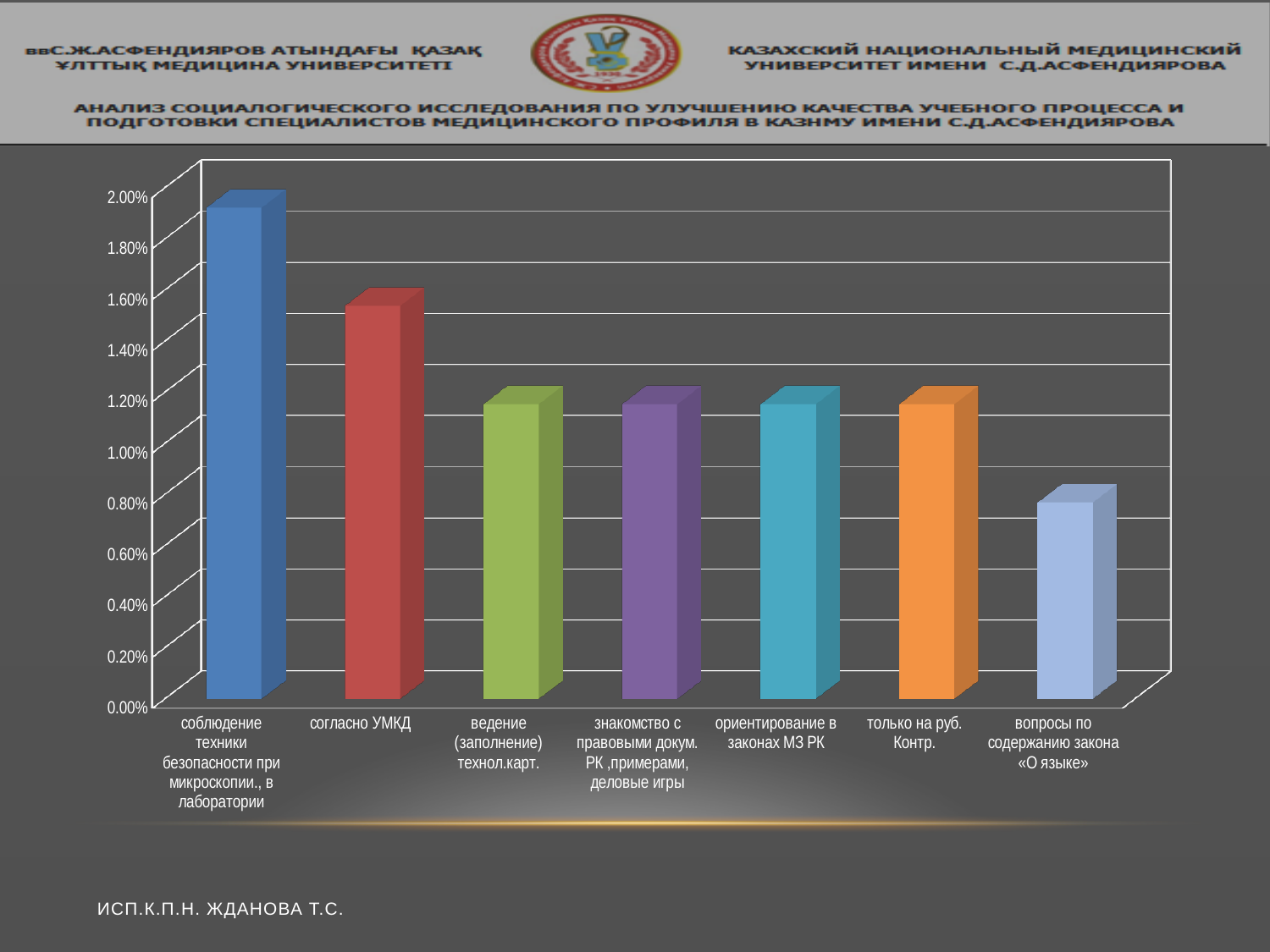
Which category has the lowest value in the chart? вопросы по содержанию закона «О языке» Which is larger: the value for "только на руб. Контр." or the value for "вопросы по содержанию закона «О языке»"? только на руб. Контр. How many categories (bars) are shown in the chart? 7 Is the value for "вопросы по содержанию закона «О языке»" greater or less than 1.00%? less Is the value for "ориентирование в законах МЗ РК" greater or less than 1.40%? less Is the value for "согласно УМКД" greater or less than 1.40%? greater What kind of chart is shown on the slide? bar chart What colour is the bar for "согласно УМКД"? red Which is larger: the value for "соблюдение техники безопасности при микроскопии., в лаборатории" or the value for "согласно УМКД"? соблюдение техники безопасности при микроскопии., в лаборатории Which category has the highest value in the chart? соблюдение техники безопасности при микроскопии., в лаборатории